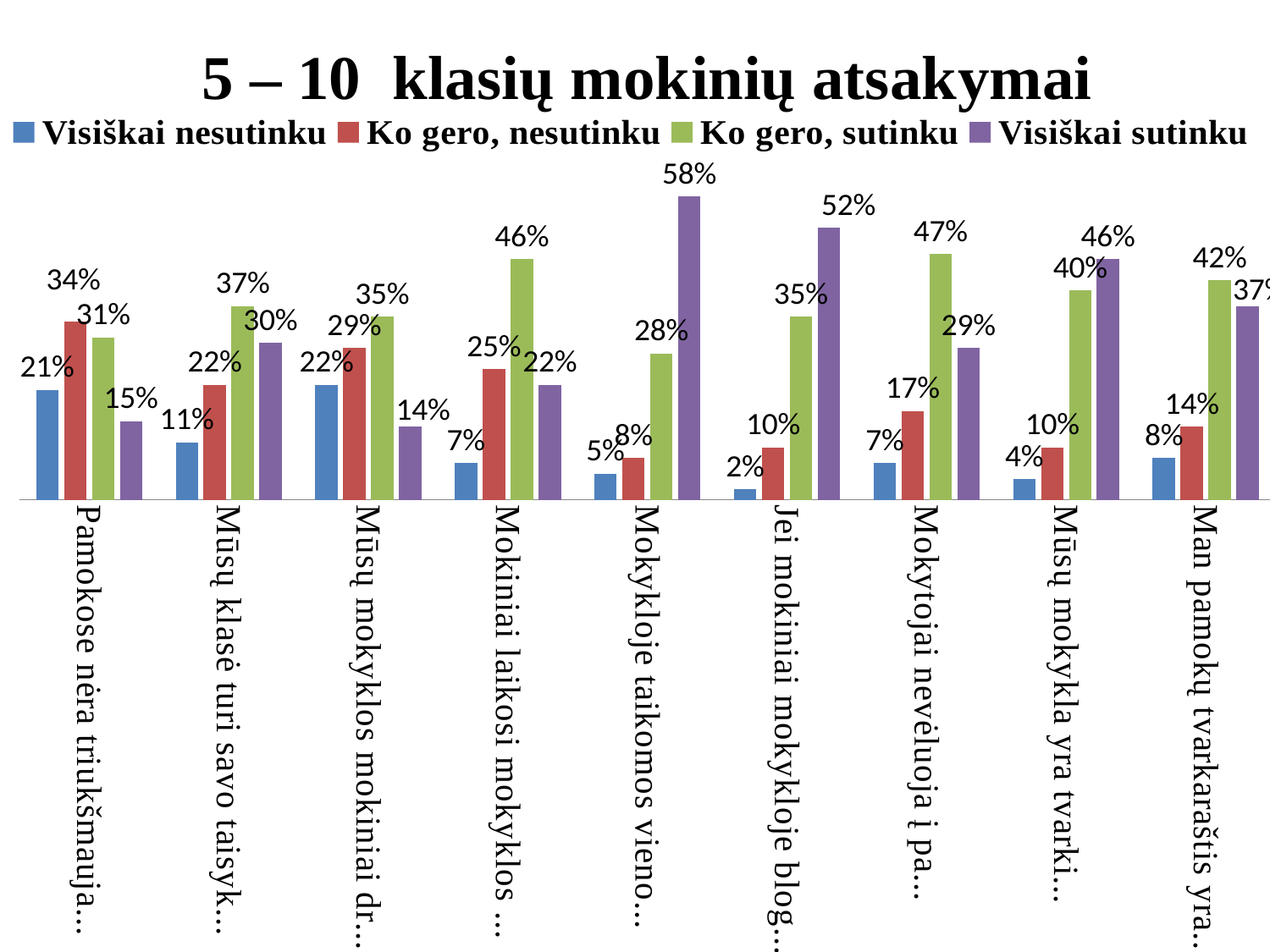
What is the value of "Ko gero, nesutinku" for the category beginning "Pamokose nėra triukšmauja..."? 34% How many categories (statements) are shown along the x axis? 9 For the category beginning "Mūsų klasė turi savo taisyk...", which is larger: "Ko gero, sutinku" or "Visiškai sutinku"? Ko gero, sutinku What is the difference between the "Ko gero, sutinku" and "Visiškai sutinku" values for the category beginning "Mokytojai nevėluoja į pa..."? 18% Which category has the lowest "Visiškai nesutinku" value? Jei mokiniai mokykloje blog... How many series does the legend list? 4 Which category has the highest "Visiškai sutinku" value? Mokykloje taikomos vieno... What is the value of "Visiškai sutinku" for the category beginning "Mokykloje taikomos vieno..."? 58% What is the value of "Ko gero, sutinku" for the category beginning "Man pamokų tvarkaraštis yra..."? 42% What is the value of "Visiškai nesutinku" for the category beginning "Jei mokiniai mokykloje blog..."? 2% What is the title of the chart? 5 – 10 klasių mokinių atsakymai What type of chart is shown on the slide? bar chart